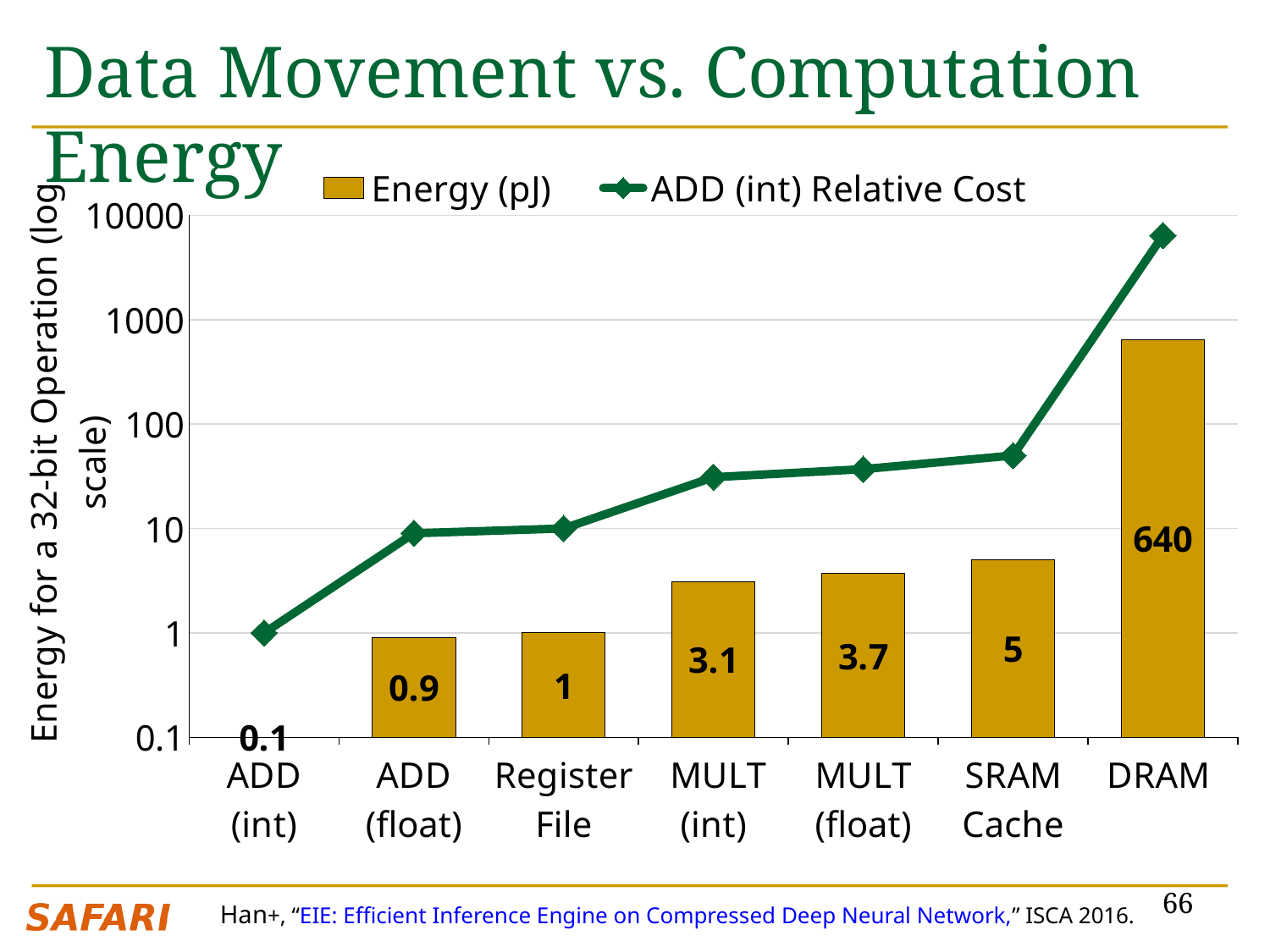
Which has a higher Energy (pJ), MULT (int) or SRAM Cache? SRAM Cache How many categories are shown on the x axis? 7 Which category has the lowest Energy (pJ)? ADD (int) What is the difference in Energy (pJ) between DRAM and SRAM Cache? 635 What is the Energy (pJ) value for MULT (float)? 3.7 What is the Energy (pJ) value for ADD (int)? 0.1 Which category has the highest Energy (pJ)? DRAM Is the ADD (int) Relative Cost for DRAM greater or less than 1000? greater What is the Energy (pJ) value for DRAM? 640 Do the Energy (pJ) values rise or fall from ADD (int) to DRAM along the x axis? rise How many series does the legend list? 2 Is the ADD (int) Relative Cost for SRAM Cache greater or less than 100? less